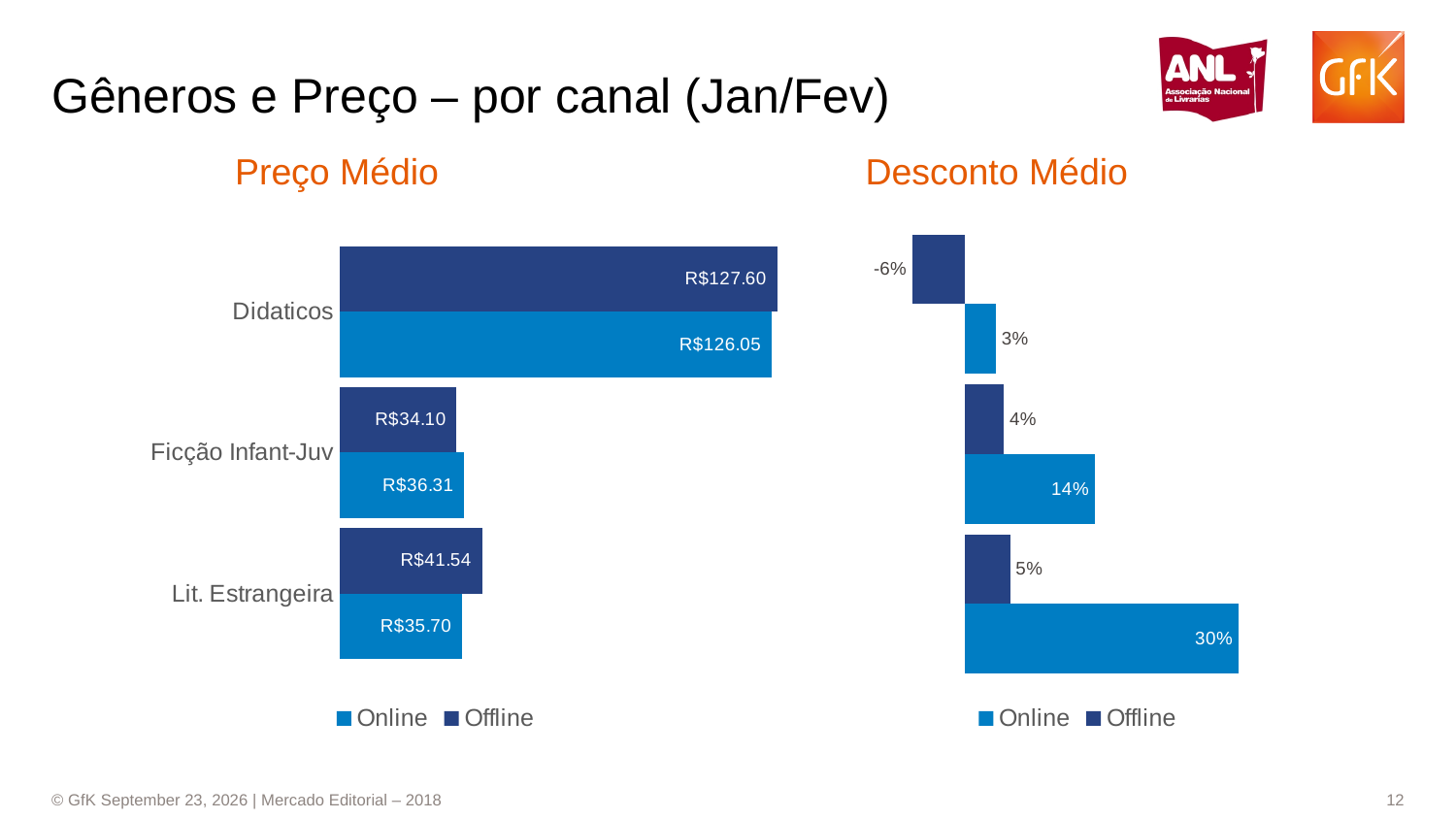
How many series does the legend of the Desconto Médio chart list? 2 What type of chart is the Desconto Médio chart? Bar chart In the Desconto Médio chart, what is the lowest Offline value shown? -6% In the Preço Médio chart, what is the Offline value for Lit. Estrangeira? R$41.54 In the Preço Médio chart, what is the difference between the Offline and Online values for Lit. Estrangeira? R$5.84 In the Preço Médio chart, which category has the highest Online value? Didaticos In the Preço Médio chart, is the Online or the Offline value larger for Ficção Infant-Juv? Online In the Desconto Médio chart, what is the highest Online value shown? 30% In the Preço Médio chart, which category has the lowest Offline value? Ficção Infant-Juv In the Preço Médio chart, what is the Offline value for Didaticos? R$127.60 In the Preço Médio chart, what is the Online value for Ficção Infant-Juv? R$36.31 How many categories are shown in the Preço Médio chart? 3